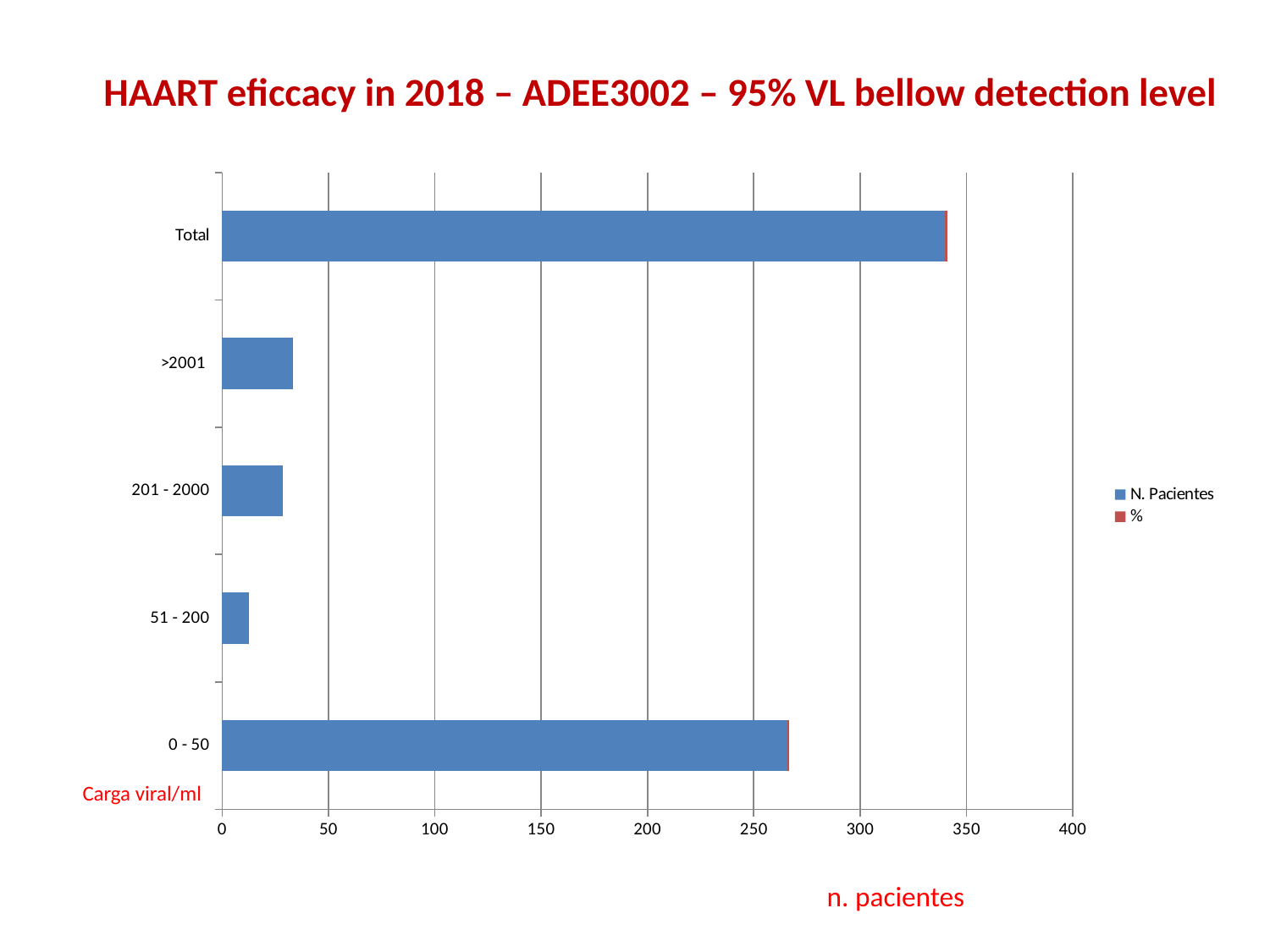
Which category has the lowest N. Pacientes value? 51 - 200 How many categories are shown on the vertical axis of the chart? 5 How many series does the chart legend list? 2 What kind of chart is shown on the slide? bar chart Is the N. Pacientes value for Total greater or less than 300? greater What are the two entries listed in the chart legend? N. Pacientes and % Which has a larger N. Pacientes value, 0 - 50 or >2001? 0 - 50 Which category has the highest N. Pacientes value? Total What label is shown below the horizontal axis of the chart? n. pacientes Is the N. Pacientes value for >2001 greater or less than 50? less Is the N. Pacientes value for 0 - 50 greater or less than 250? greater